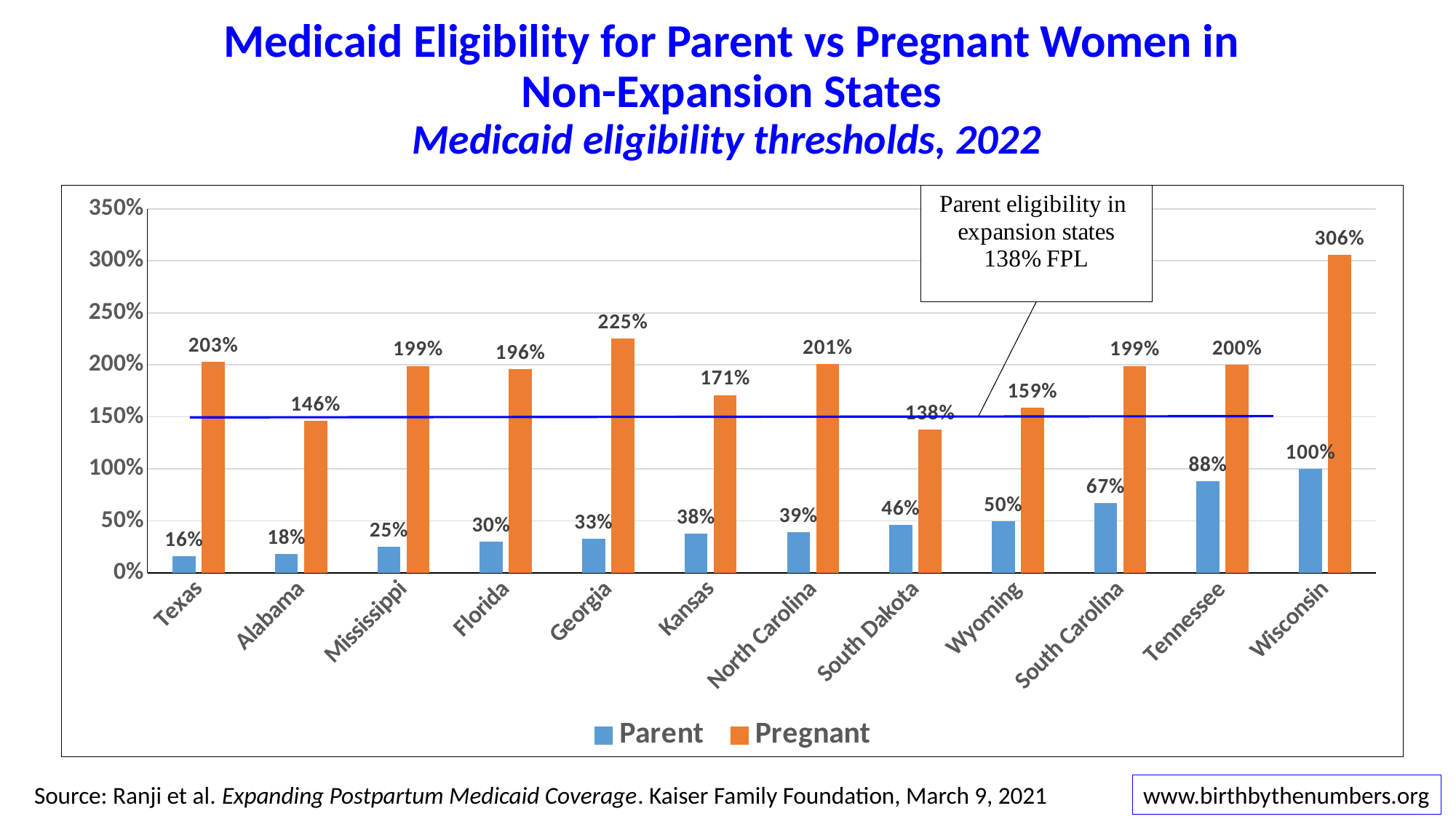
What is the difference between the Pregnant and Parent thresholds for Wisconsin? 206% How many states are shown on the x axis? 12 Which state has the highest Pregnant eligibility threshold? Wisconsin What is the Parent eligibility threshold for Tennessee? 88% What kind of chart is shown? Bar chart What value does the horizontal blue line represent, according to the annotation? 138% FPL How many series does the legend list? 2 What is the Pregnant eligibility threshold for Georgia? 225% Which state has the lowest Parent eligibility threshold? Texas Do the Parent eligibility values rise or fall from Texas to Wisconsin along the x axis? Rise What is the Parent eligibility threshold for Texas? 16% Which is larger, the Pregnant threshold for Alabama or the Pregnant threshold for Kansas? Kansas